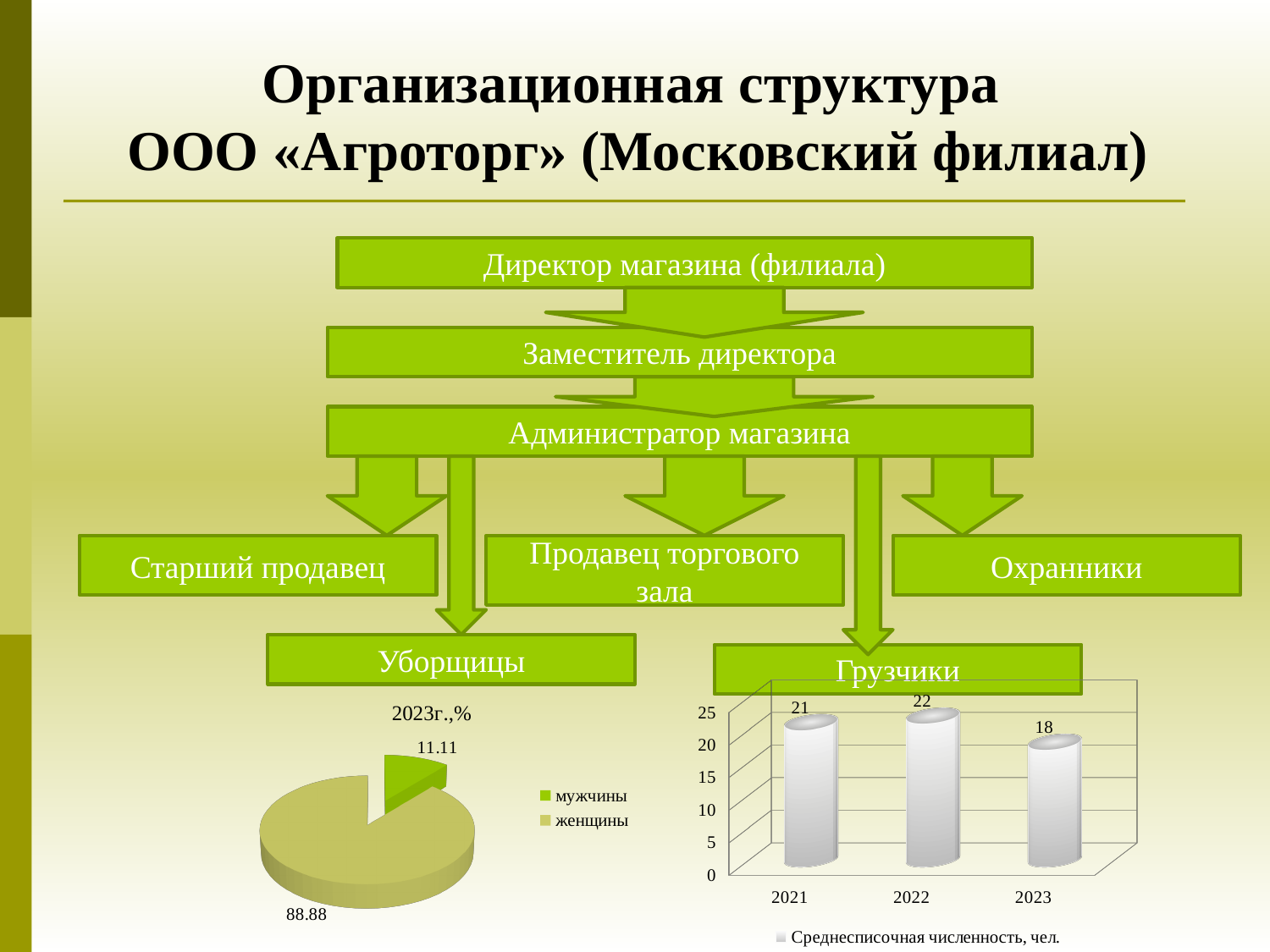
In the bar chart on the right, how many years are shown on the x axis? 3 In the bar chart on the right, which year has the lowest value? 2023 In the pie chart titled "2023г.,%", how many entries does the legend list? 2 In the pie chart titled "2023г.,%", what is the value for мужчины? 11.11 In the bar chart on the right, what is the value for 2023? 18 What kind of chart is the chart titled "2023г.,%" on the left? pie chart In the bar chart on the right, what is the legend entry for the plotted series? Среднесписочная численность, чел. In the bar chart on the right, which year has the highest value? 2022 In the pie chart titled "2023г.,%", which category has the largest slice? женщины In the bar chart on the right, what is the value for 2022? 22 In the bar chart on the right, what is the difference between the values for 2021 and 2023? 3 In the pie chart titled "2023г.,%", what is the value for женщины? 88.88